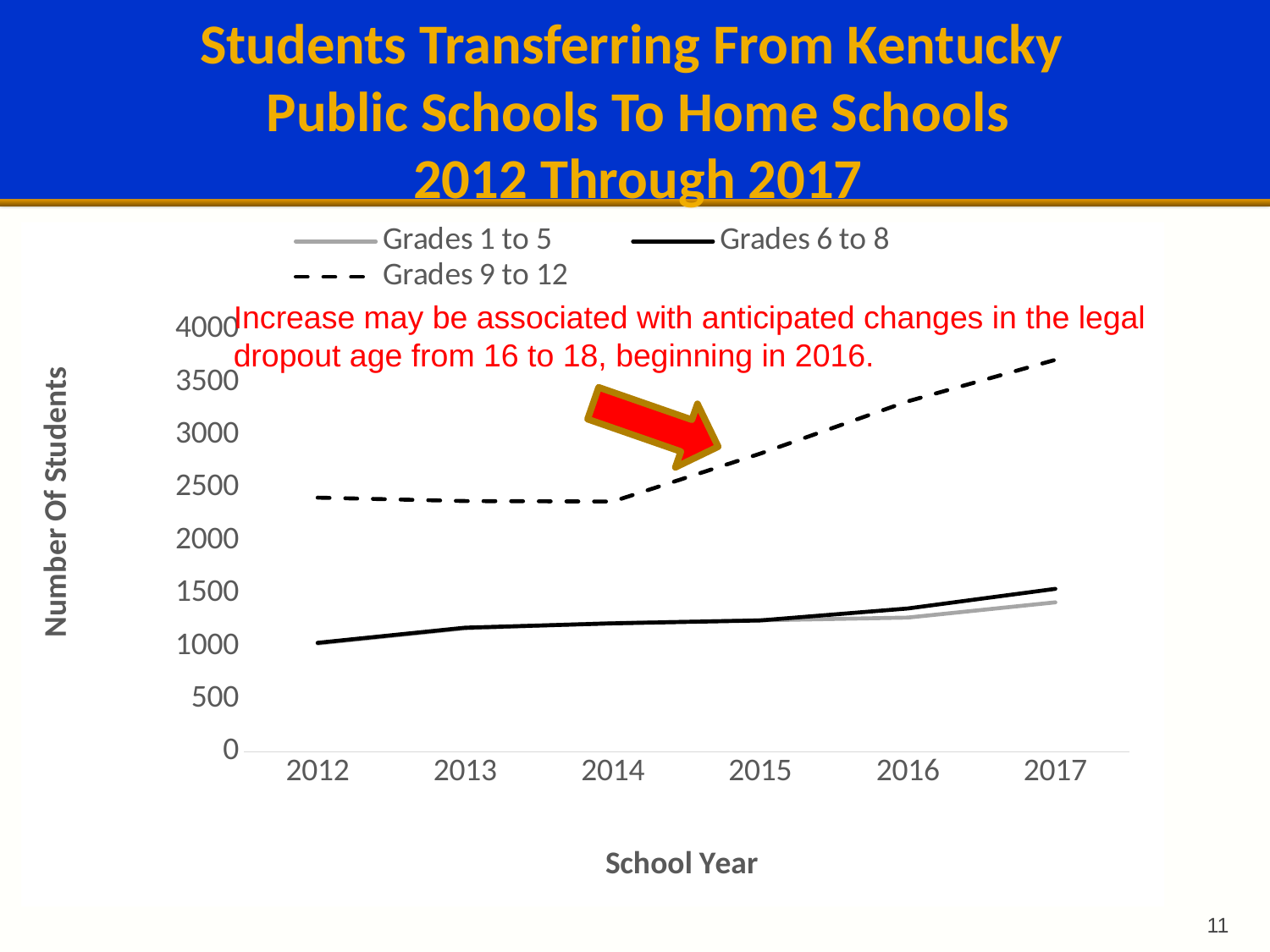
Is the value for Grades 1 to 5 in 2017 greater or less than 1500? less Is the value for Grades 9 to 12 in 2017 greater or less than 3500? greater How many series does the legend list? 3 In 2015, which is larger: the value for Grades 9 to 12 or the value for Grades 6 to 8? Grades 9 to 12 Which series has the highest value in 2017? Grades 9 to 12 How many school years are plotted along the x axis? 6 Does the Grades 9 to 12 series rise or fall from 2014 to 2017? Rise Is the value for Grades 9 to 12 in 2014 greater or less than 2500? less What kind of chart is shown on the slide? Line chart What is the title of the vertical axis? Number Of Students